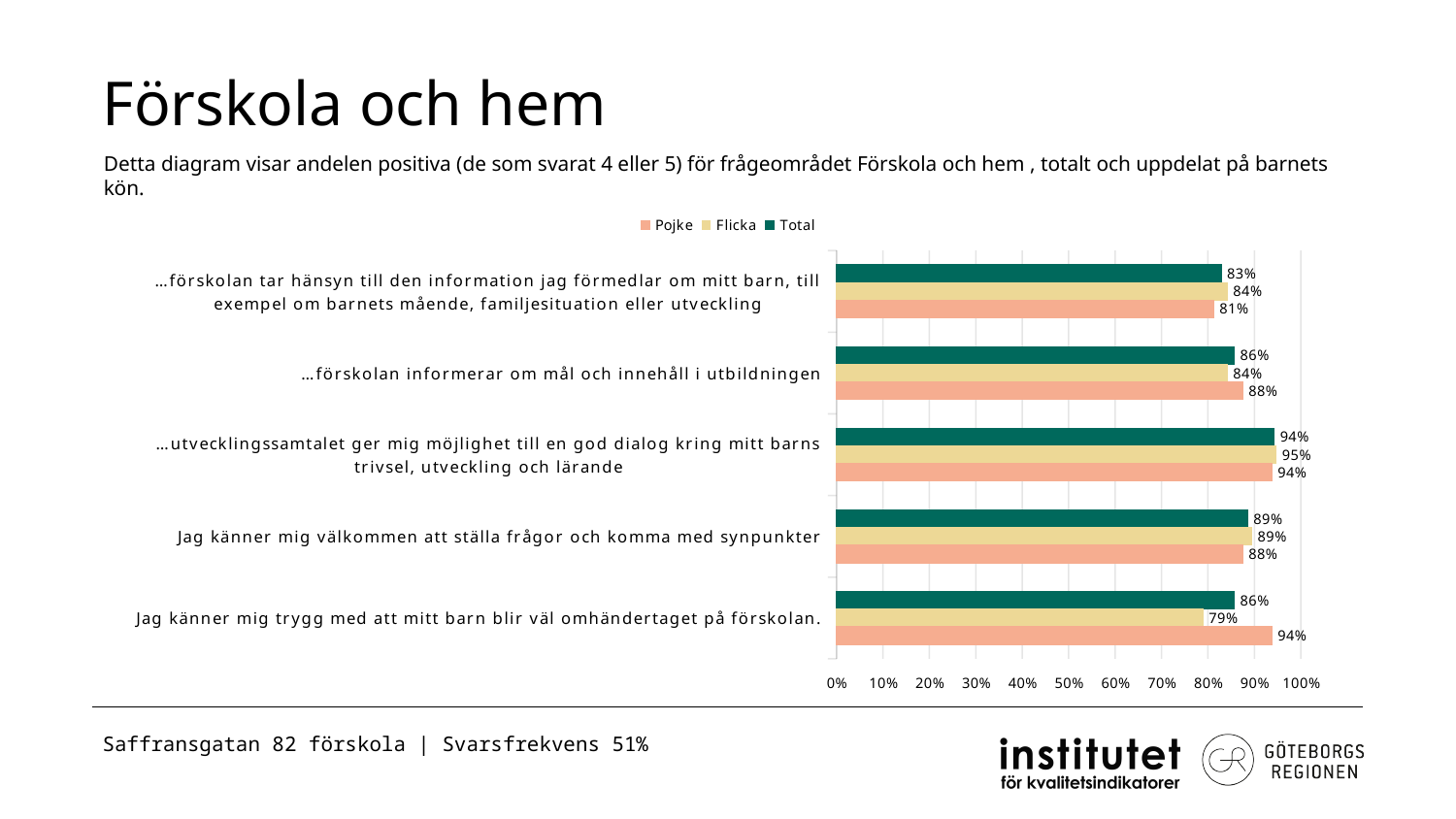
What is the Pojke value for "Jag känner mig trygg med att mitt barn blir väl omhändertaget på förskolan."? 94% Which series is shown in green in the chart? Total What is the Pojke value for "…förskolan tar hänsyn till den information jag förmedlar om mitt barn, till exempel om barnets mående, familjesituation eller utveckling"? 81% What is the Flicka value for "Jag känner mig trygg med att mitt barn blir väl omhändertaget på förskolan."? 79% What kind of chart is shown on the slide? Bar chart Which category has the highest Total value? …utvecklingssamtalet ger mig möjlighet till en god dialog kring mitt barns trivsel, utveckling och lärande How many categories are shown in the chart? 5 For "…förskolan informerar om mål och innehåll i utbildningen", which is larger, the Pojke value or the Flicka value? Pojke Which category has the lowest Flicka value? Jag känner mig trygg med att mitt barn blir väl omhändertaget på förskolan. What is the difference between the Pojke and Flicka values for "Jag känner mig trygg med att mitt barn blir väl omhändertaget på förskolan."? 15 percentage points What is the Total value for "…förskolan informerar om mål och innehåll i utbildningen"? 86% How many series does the legend list? 3